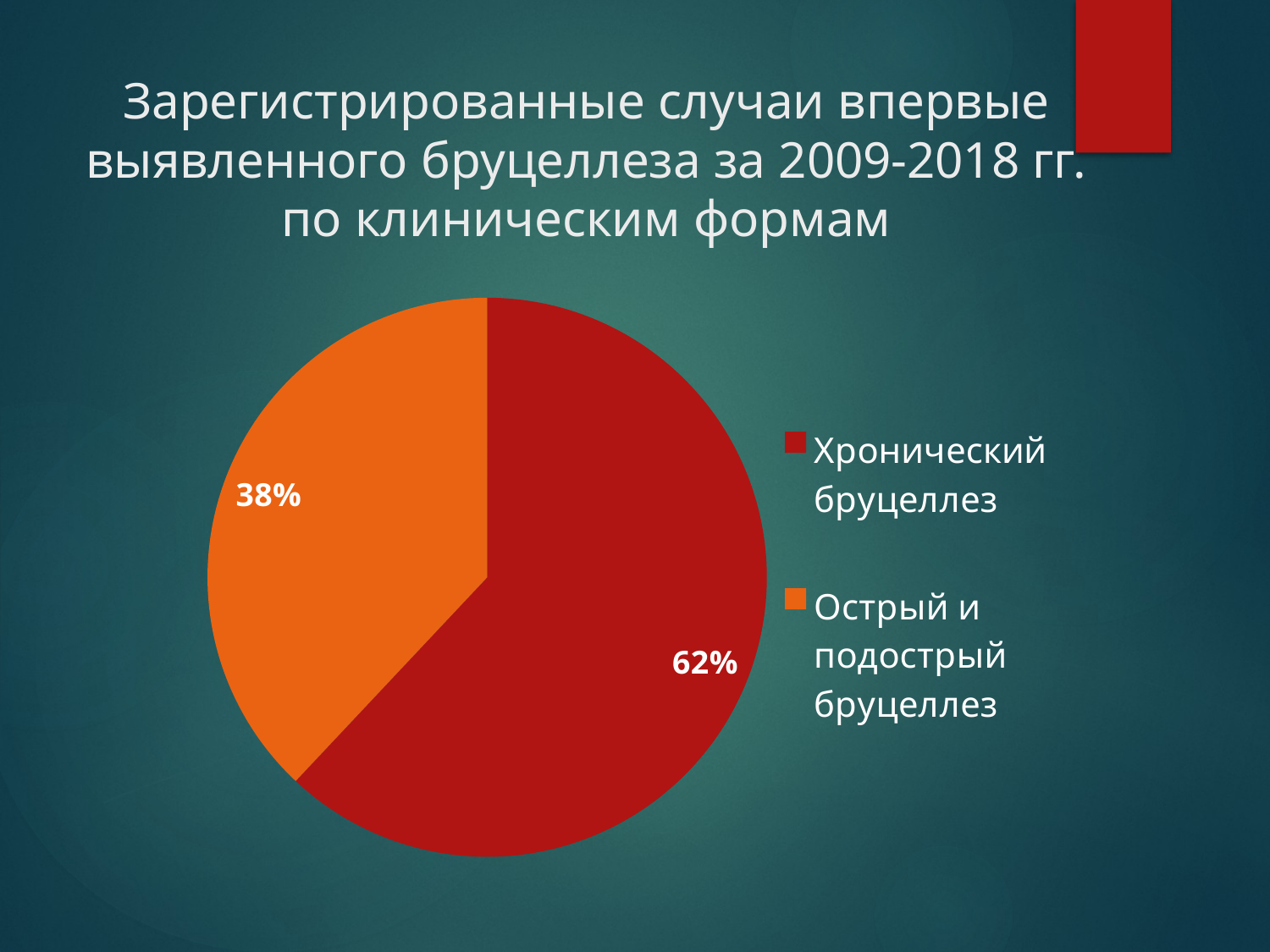
Which clinical form has the largest slice of the pie? Хронический бруцеллез What colour is the slice for Острый и подострый бруцеллез? Orange What share of the pie is labelled for Хронический бруцеллез? 62% How many entries does the legend list? 2 What is the difference in percentage points between the Хронический бруцеллез slice and the Острый и подострый бруцеллез slice? 24 What share of the pie is labelled for Острый и подострый бруцеллез? 38% How many slices does the pie chart have? 2 What colour is the slice for Хронический бруцеллез? Red Which clinical form has the smallest slice of the pie? Острый и подострый бруцеллез Which is larger: the slice for Хронический бруцеллез or the slice for Острый и подострый бруцеллез? Хронический бруцеллез Is the share for Хронический бруцеллез greater or less than 50%? greater What kind of chart is shown on the slide? Pie chart